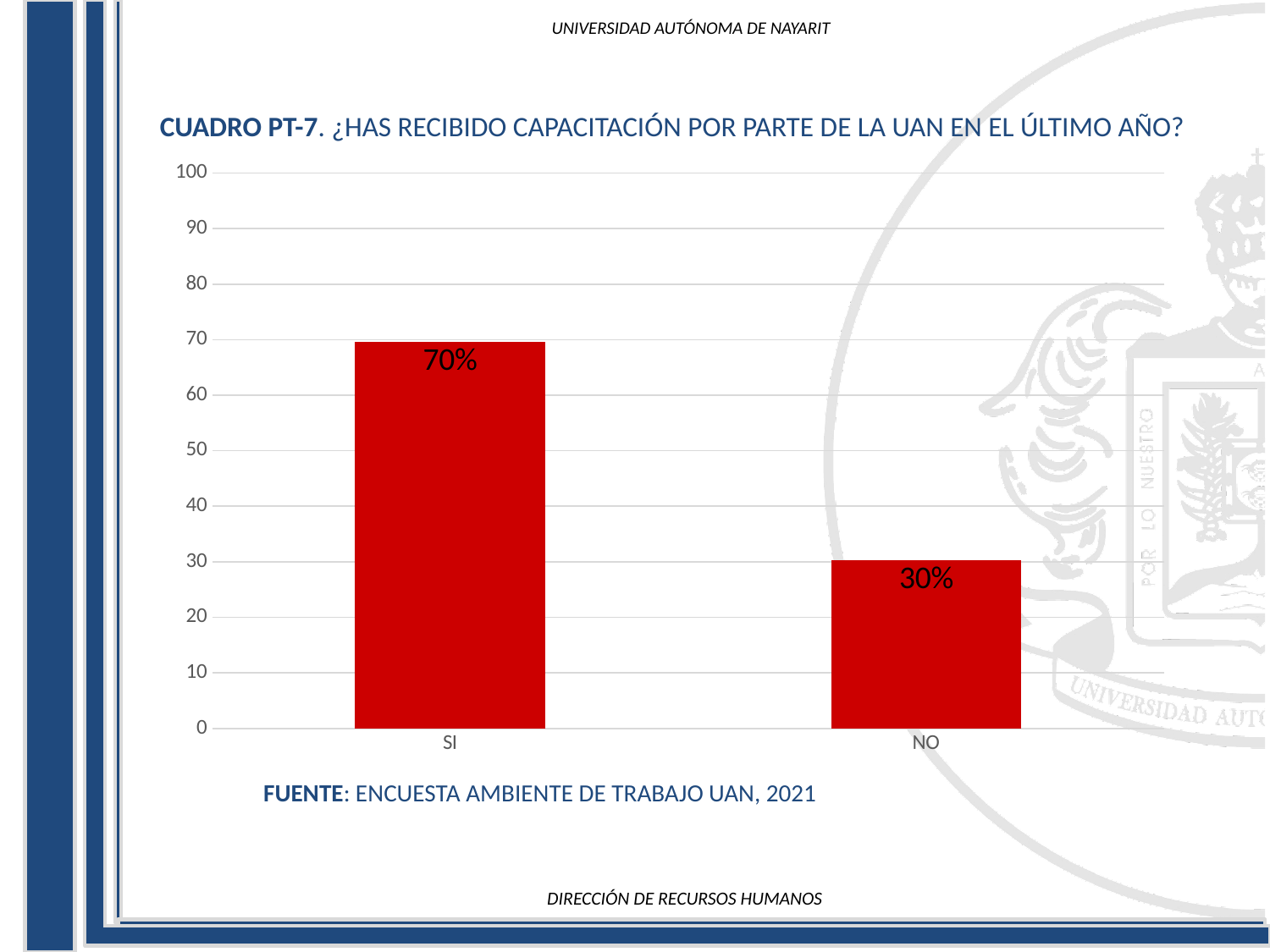
How many categories are shown on the x axis? 2 Which is larger, the value for SI or the value for NO? SI Which category has the highest value? SI What colour are the bars in the chart? red What is the title of the chart? CUADRO PT-7. ¿HAS RECIBIDO CAPACITACIÓN POR PARTE DE LA UAN EN EL ÚLTIMO AÑO? Is the value for SI greater or less than 60? greater Is the value for NO greater or less than 40? less What kind of chart is shown on the slide? bar chart Which category has the lowest value? NO What is the value for SI? 70% What is the difference between the values for SI and NO? 40% What is the value for NO? 30%